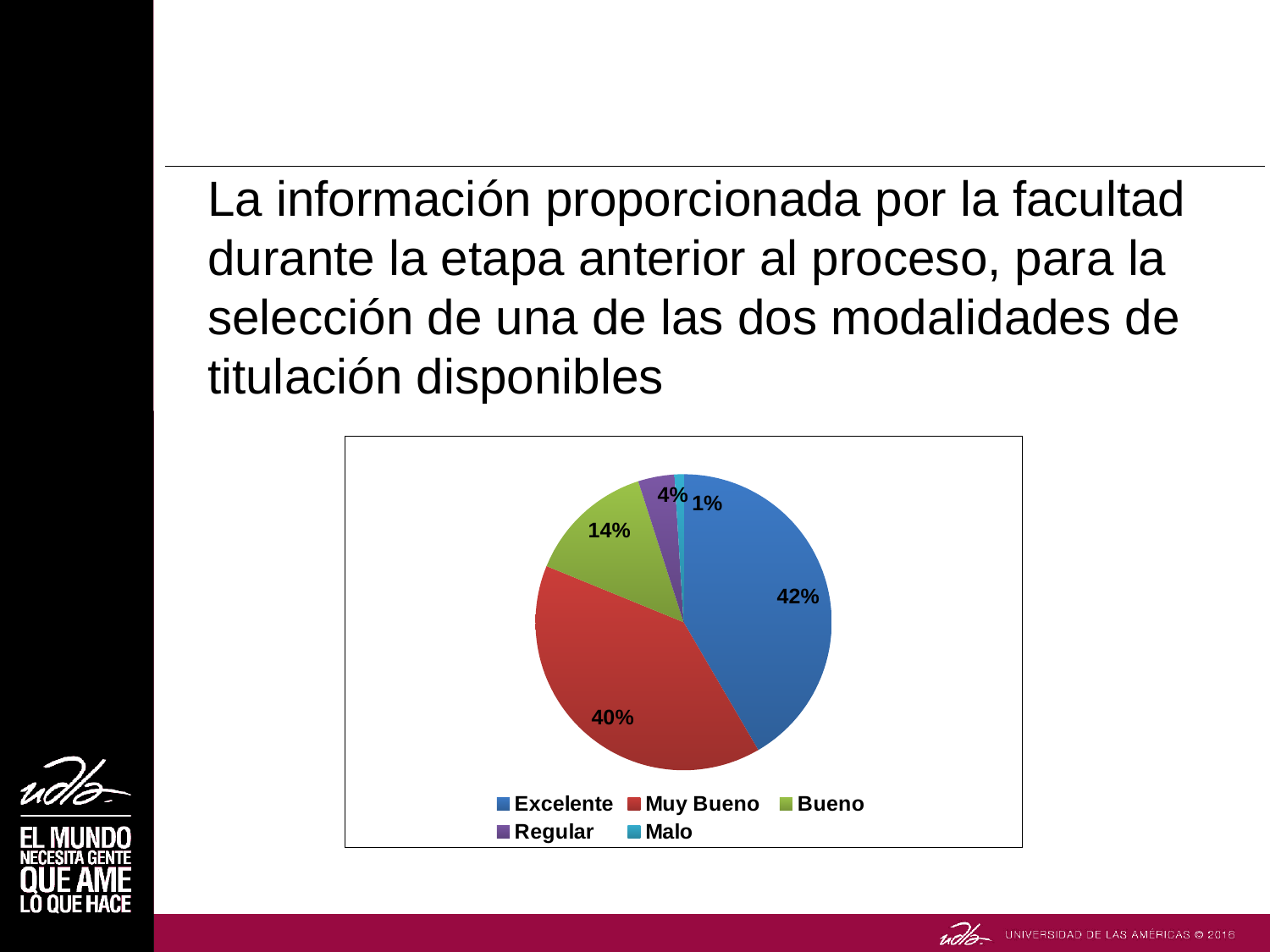
What percentage of the pie is labelled Malo? 1% Which is larger, the share for Bueno or the share for Regular? Bueno What percentage of the pie is labelled Muy Bueno? 40% What is the difference in percentage points between Bueno and Regular? 10 What percentage of the pie is labelled Regular? 4% What kind of chart is shown on the slide? pie chart What percentage of the pie is labelled Excelente? 42% Which category has the largest share of the pie? Excelente Which category has the smallest share of the pie? Malo How many categories does the legend list? 5 What percentage of the pie is labelled Bueno? 14% What colour is the Muy Bueno slice? red